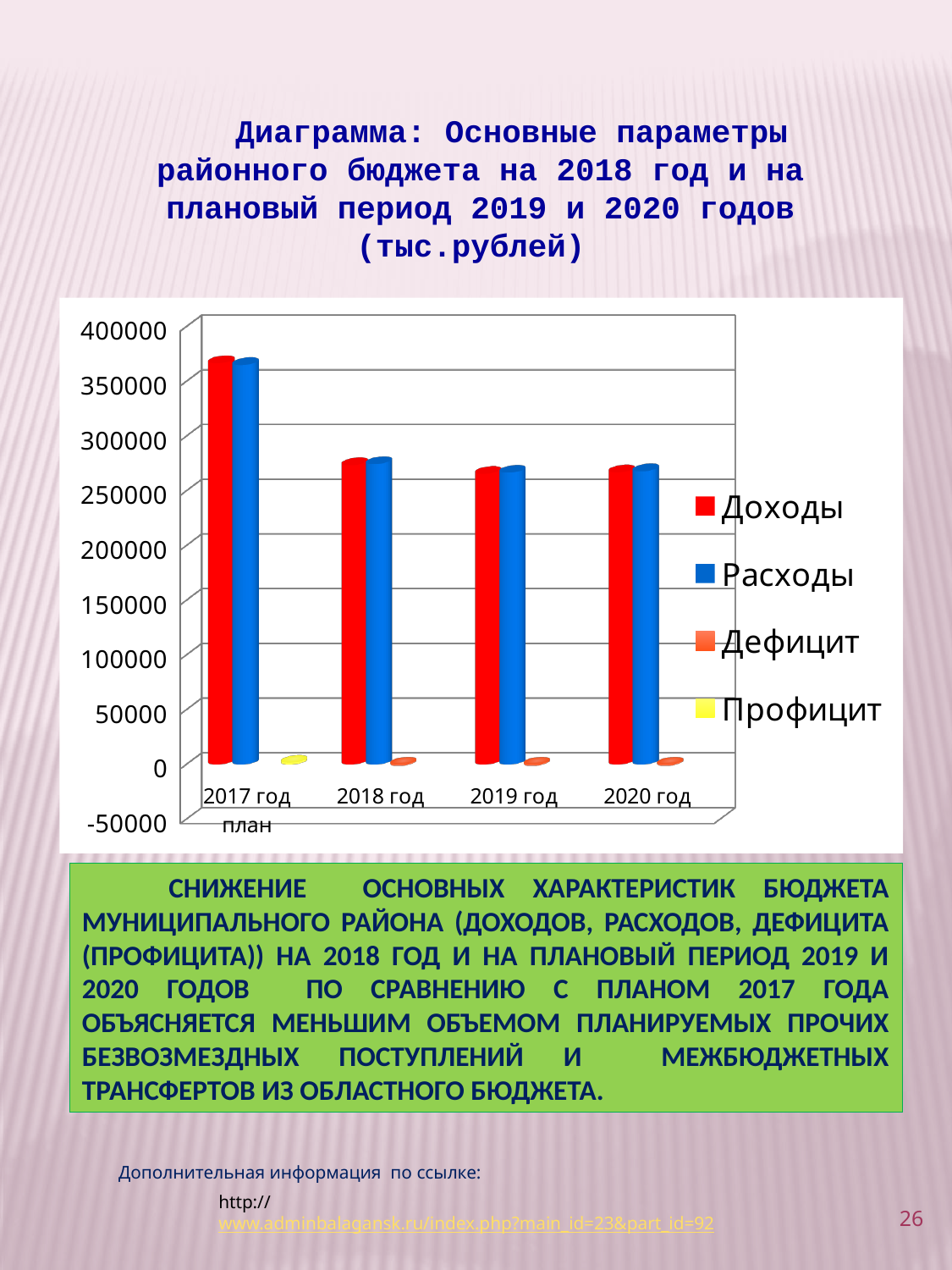
How many categories (years) are shown on the x axis of the chart? 4 Is the value of Доходы for 2018 год greater or less than 300000? less What kind of chart is shown on the slide? bar chart What colour represents the Доходы series in the legend? red Is the value of Доходы for 2017 год план greater or less than 350000? greater How many series does the chart legend list? 4 In which year is the value of Доходы the highest? 2017 год план Do the Расходы values rise or fall from 2017 год план to 2018 год? fall Is the value of Расходы for 2019 год greater or less than 250000? greater Which is larger: Доходы for 2017 год план or Доходы for 2020 год? 2017 год план Which legend entry is shown in yellow? Профицит